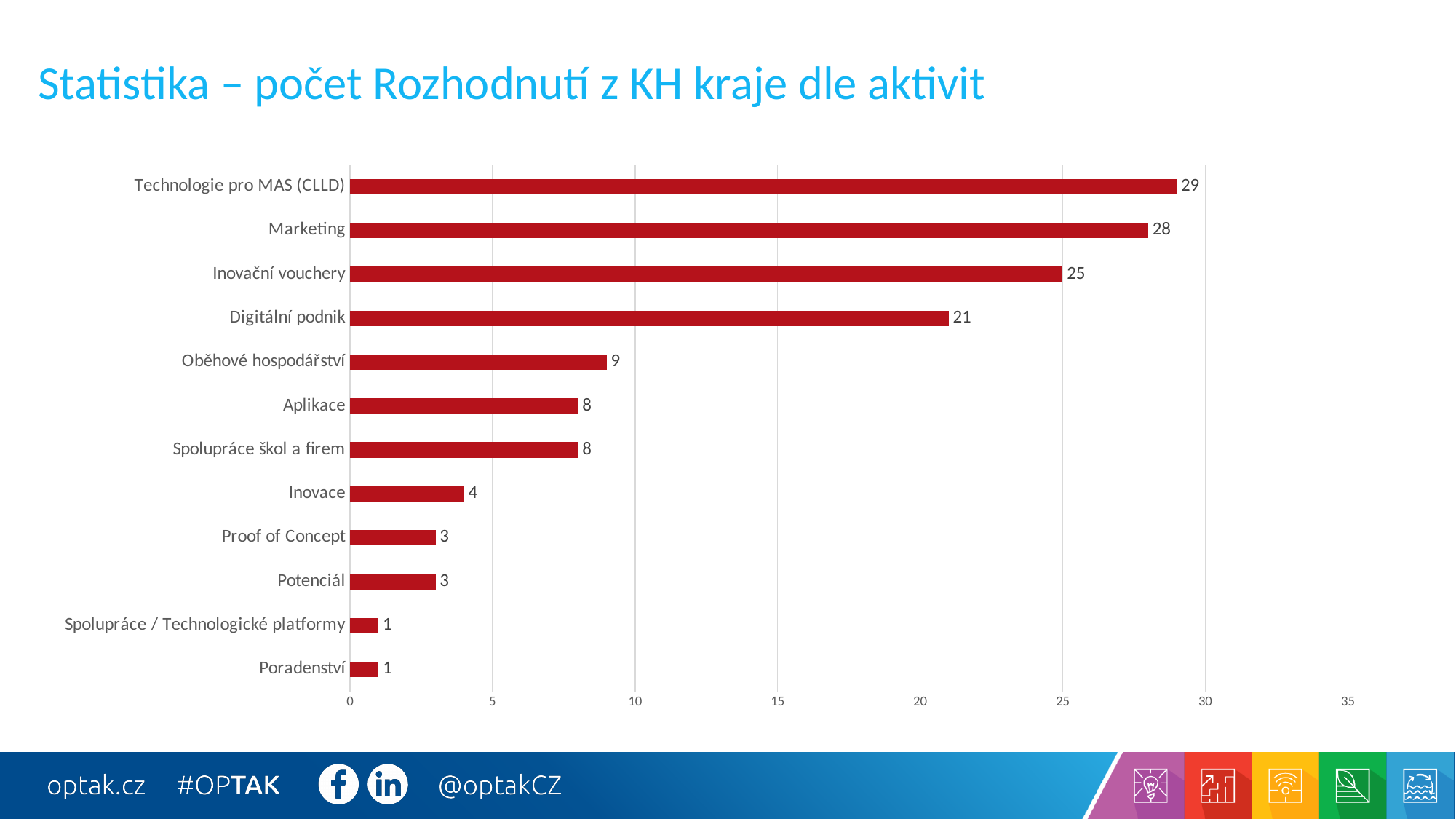
Which is larger, the value for Inovace or the value for Proof of Concept? Inovace How many categories are shown in the chart? 12 What is the title of the slide? Statistika – počet Rozhodnutí z KH kraje dle aktivit Which category has the highest value? Technologie pro MAS (CLLD) What is the difference between the values for Technologie pro MAS (CLLD) and Inovační vouchery? 4 What kind of chart is shown on the slide? bar chart What is the value for Aplikace? 8 Is the value for Inovační vouchery greater or less than 20? greater What is the value for Marketing? 28 What is the difference between the values for Marketing and Digitální podnik? 7 What is the value for Digitální podnik? 21 What is the value for Oběhové hospodářství? 9